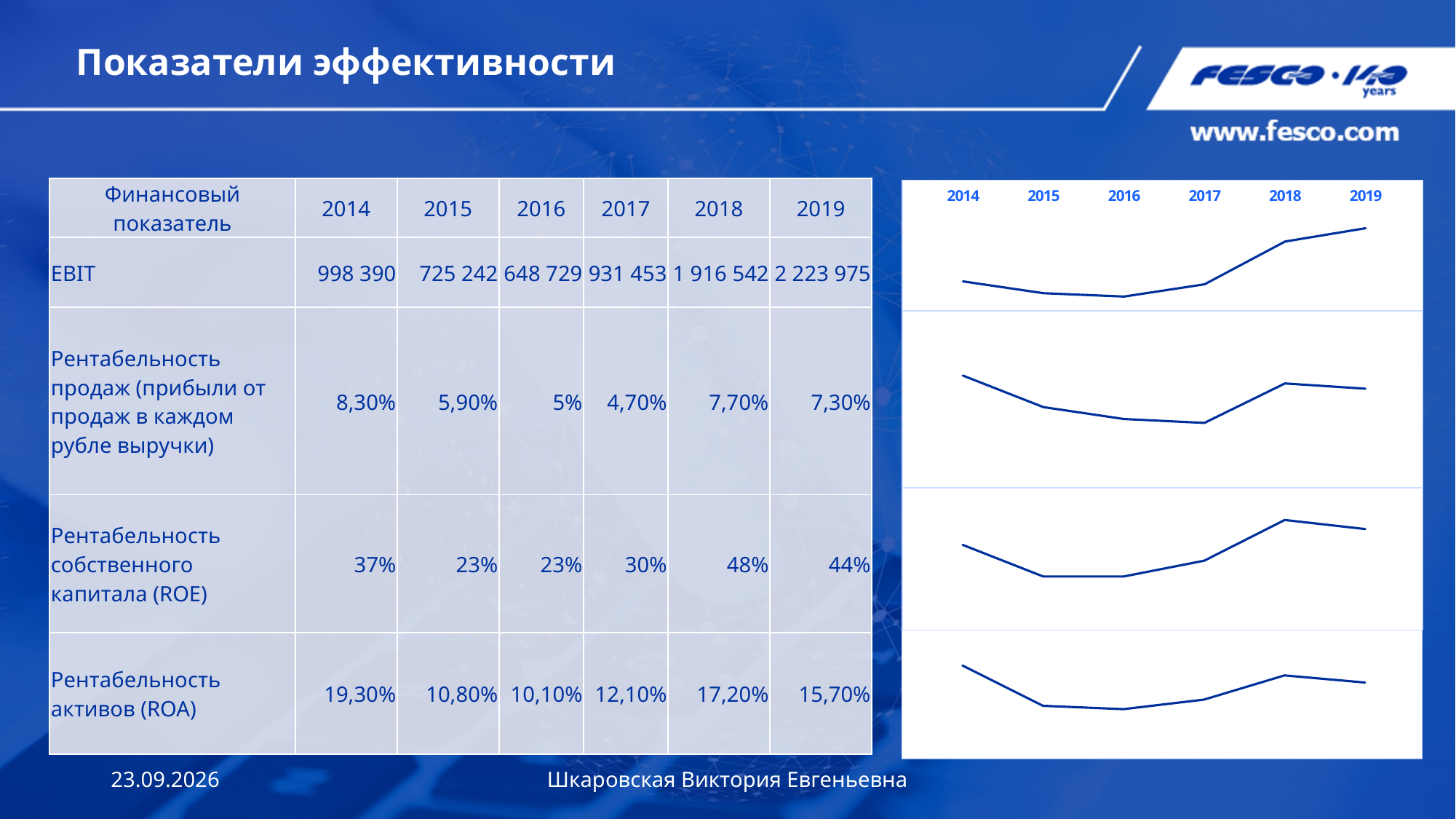
In the third line chart from the top (ROE), which year has the highest value? 2018 In the top line chart on the right (EBIT), does the line rise or fall from 2017 to 2019? rise What is the first year shown on the x axis of the charts on the right? 2014 In the second line chart from the top (Рентабельность продаж), which year has the highest value? 2014 What kind of chart is the top chart on the right side of the slide? line chart In the top line chart on the right (EBIT), which year has the lowest value? 2016 How many years are shown along the x axis of the charts on the right? 6 In the bottom line chart (ROA), does the line rise or fall from 2014 to 2016? fall In the bottom line chart (ROA), which year has the lowest value? 2016 In the third line chart from the top (ROE), is the value for 2018 or 2019 larger? 2018 In the second line chart from the top (Рентабельность продаж), which year has the lowest value? 2017 In the top line chart on the right (EBIT), which year has the highest value? 2019